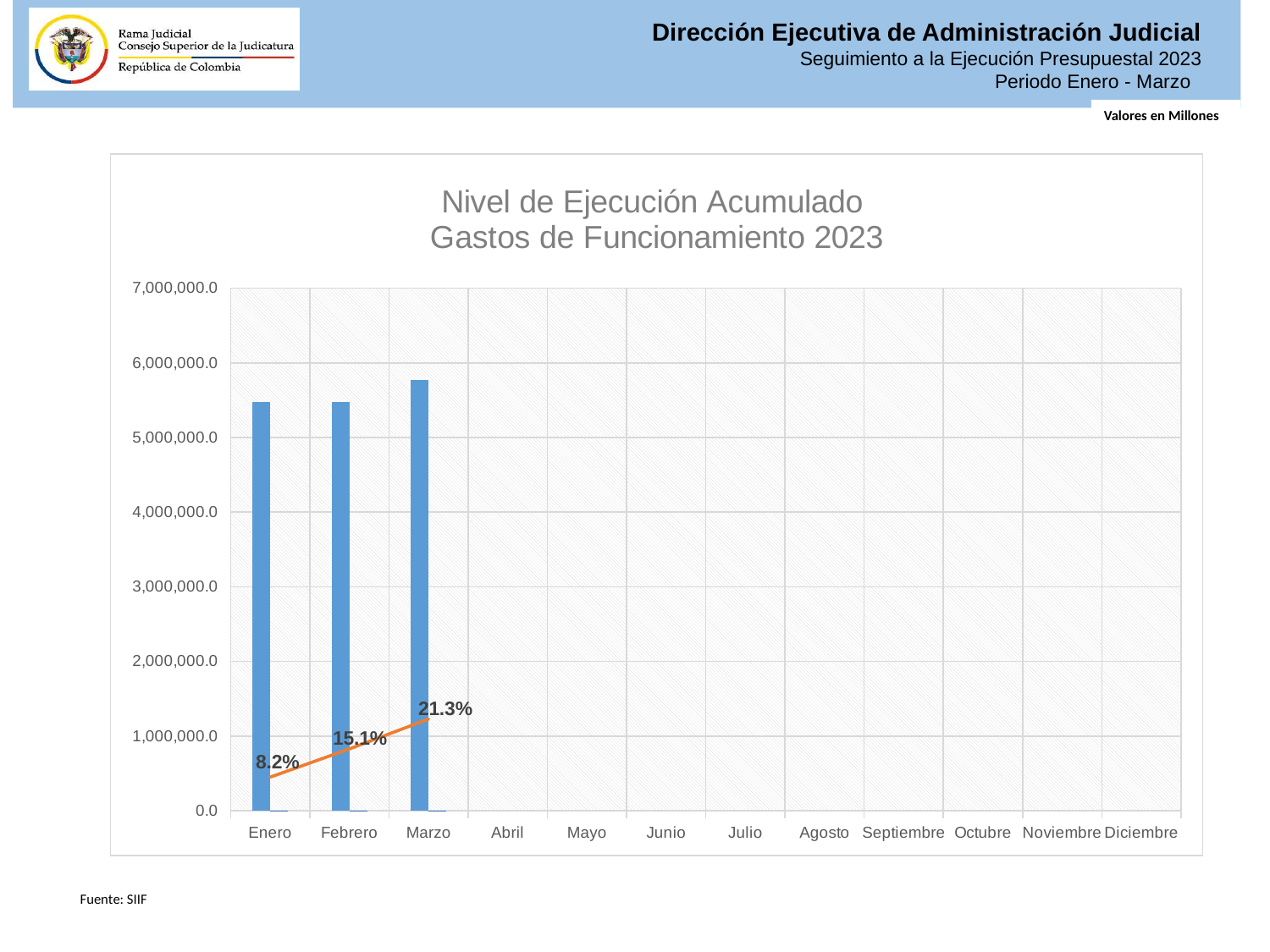
Is the bar value for Enero greater or less than 6,000,000.0? less By how many percentage points does the Marzo label exceed the Enero label? 13.1 percentage points What is the title of the chart? Nivel de Ejecución Acumulado Gastos de Funcionamiento 2023 How many months have a visible bar plotted? 3 What is the percentage label shown for Enero? 8.2% What is the percentage label shown for Marzo? 21.3% Is the bar value for Marzo greater or less than 5,000,000.0? greater By how many percentage points does the Febrero label exceed the Enero label? 6.9 percentage points What is the percentage label shown for Febrero? 15.1% Do the percentage labels rise or fall from Enero to Marzo? rise Which month has the tallest bar? Marzo How many month categories are shown on the x axis? 12